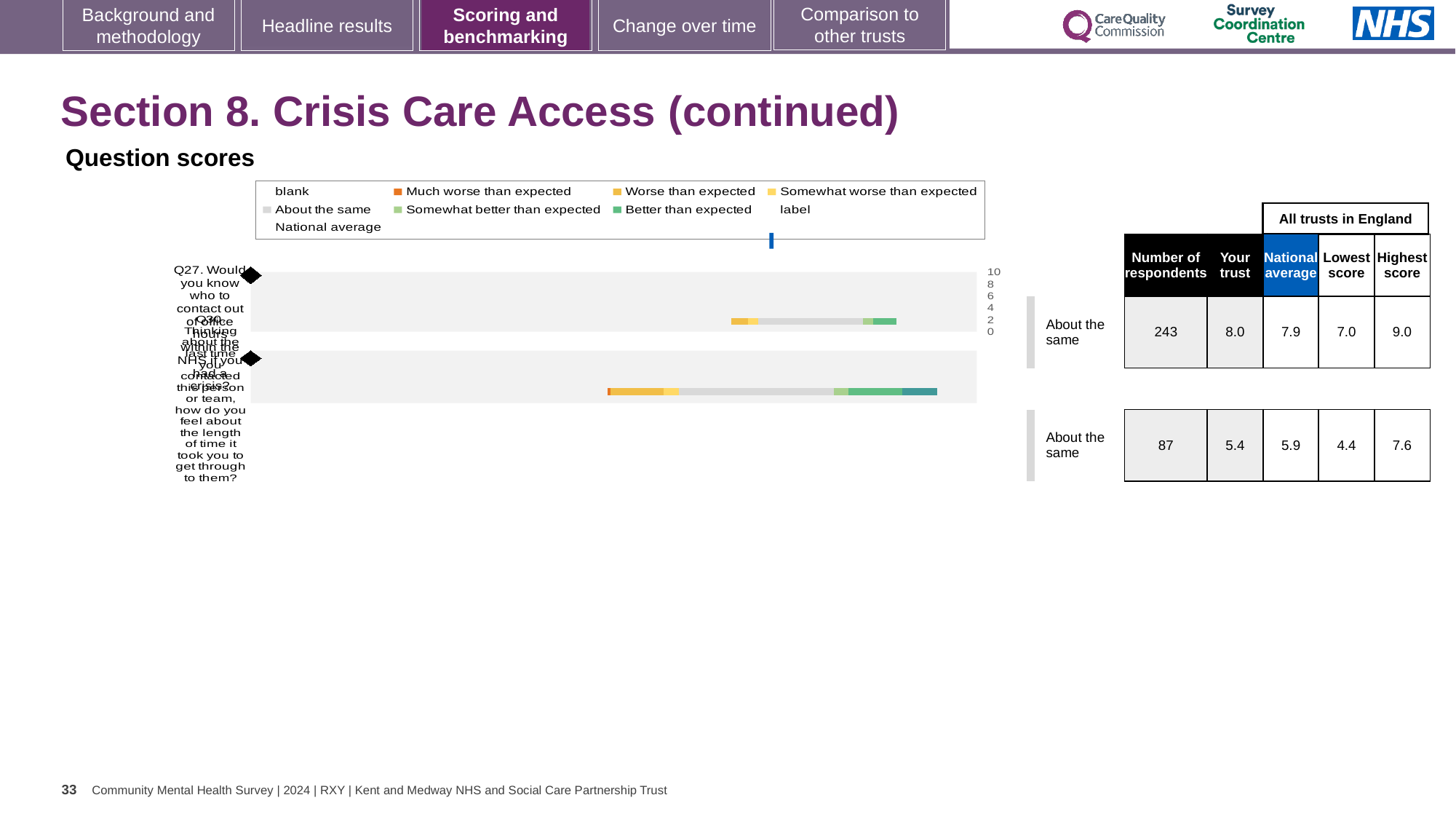
What is the highest score among all trusts in England for Q28? 7.6 What is the lowest score among all trusts in England for Q28? 4.4 What is the difference between the highest and lowest scores for Q27 across all trusts in England? 2.0 What kind of chart is used to show the question scores on this slide? bar chart What benchmark category is shown next to the Q27 bar? About the same What is the national average score for Q27? 7.9 Which question has the higher 'Your trust' score, Q27 or Q28? Q27 How many respondents answered Q27? 243 By how much does the national average for Q28 exceed the trust's score for Q28? 0.5 How many questions are plotted in the question scores chart? 2 How many respondents answered Q28 (length of time to get through to the person or team)? 87 What is the 'Your trust' score for Q27 (knowing who to contact out of office hours in a crisis)? 8.0